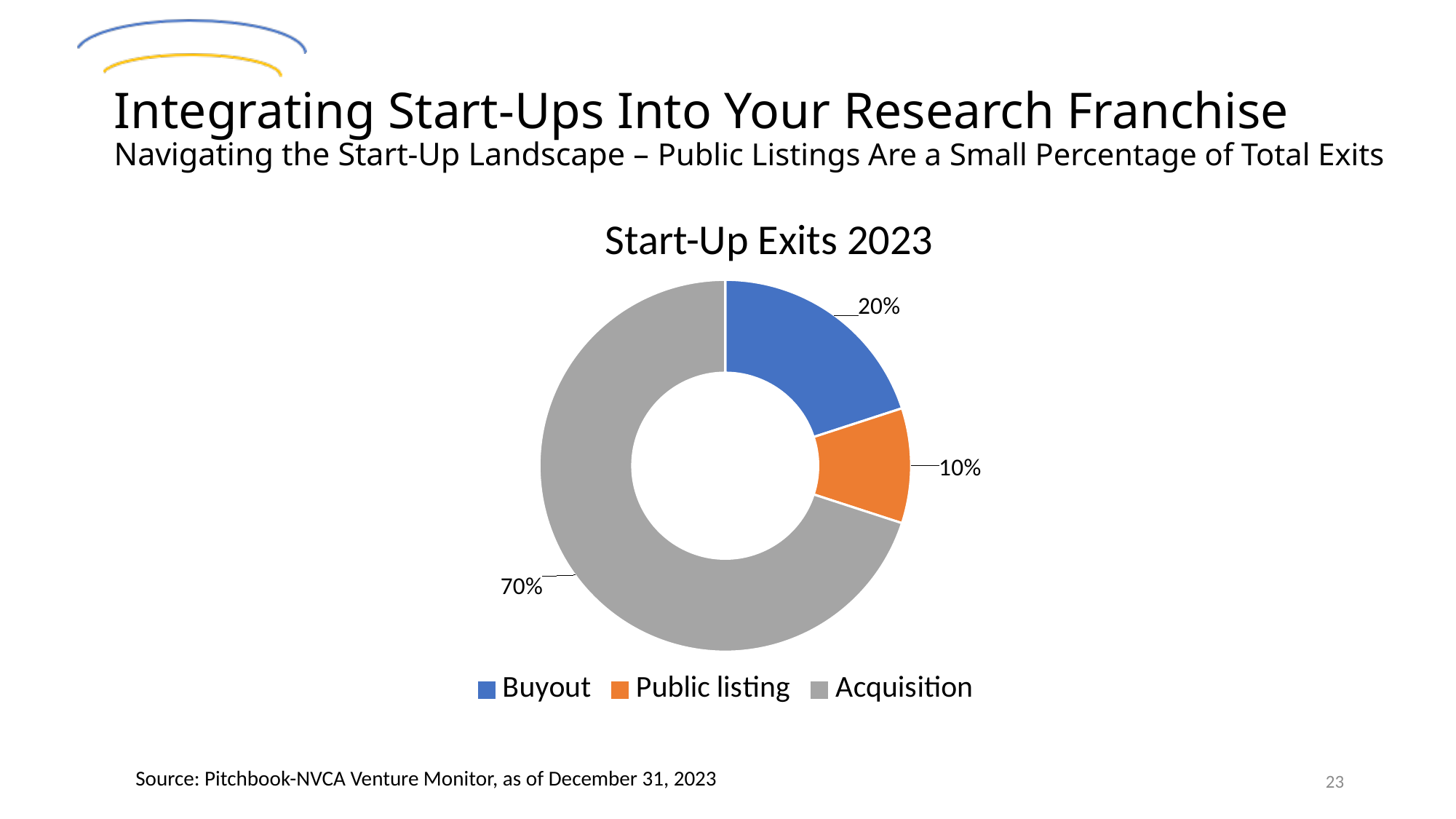
What is the difference in percentage points between the Acquisition share and the Buyout share? 50 Which exit type has the largest share in the Start-Up Exits 2023 chart? Acquisition What is the difference in percentage points between the Buyout share and the Public listing share? 10 Which is larger, the share for Buyout or the share for Public listing? Buyout How many exit categories are shown in the Start-Up Exits 2023 chart? 3 Which exit type has the smallest share in the Start-Up Exits 2023 chart? Public listing What percentage of start-up exits in 2023 were public listings? 10% What is the title of the chart on the slide? Start-Up Exits 2023 What percentage of start-up exits in 2023 were acquisitions? 70% What kind of chart is used to show Start-Up Exits 2023? Doughnut (pie) chart What colour represents Acquisition in the chart? Gray What percentage of start-up exits in 2023 were buyouts? 20%